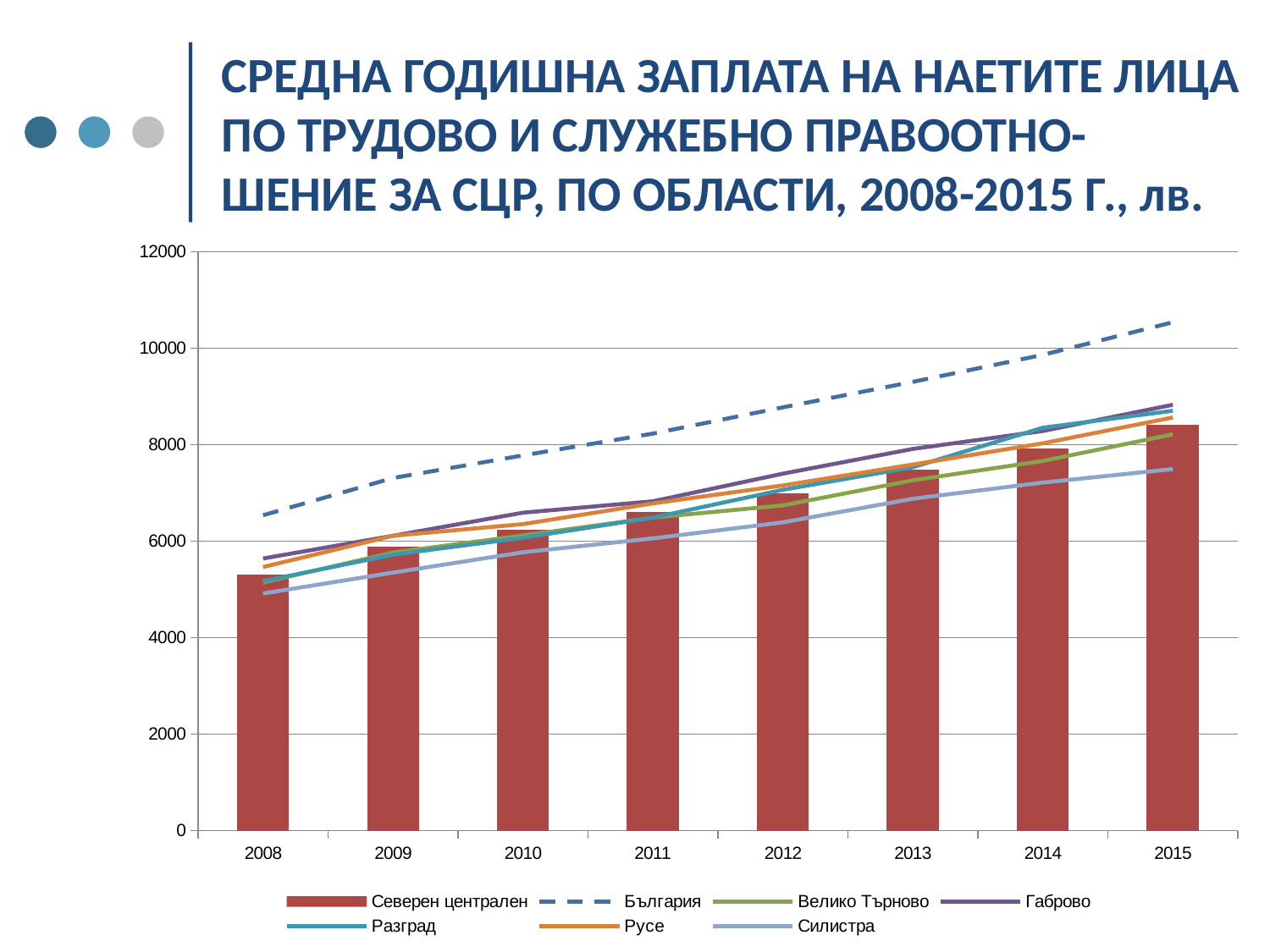
Is the value for България in 2015 greater or less than 10000? greater Which series has the lowest value in 2015? Силистра Which series has the highest value in 2015? България Is the value for Северен централен in 2008 greater or less than 6000? less Which series has the lowest value in 2008? Силистра What kind of chart is shown on the slide? A combination of a bar chart and line chart Which series is drawn as a dashed line in the chart? България How many years are shown on the x axis of the chart? 8 Do the values for Северен централен rise or fall from 2008 to 2015? Rise How many series does the chart legend list? 7 Which is larger in 2015, the value for България or the value for Силистра? България Which series is shown as bars in the chart? Северен централен